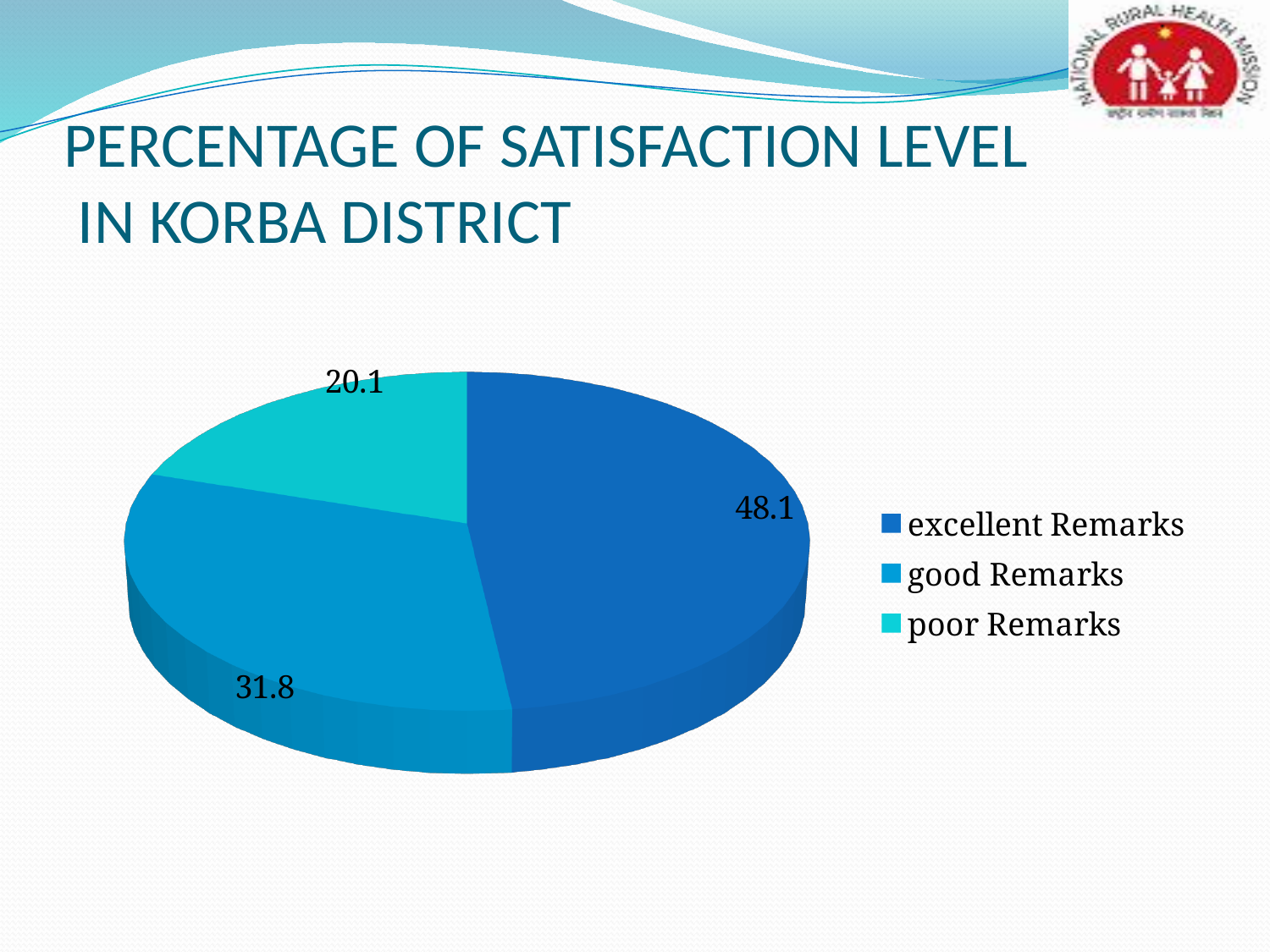
Which category has the smallest slice of the pie? poor Remarks What is the difference between the values for excellent Remarks and good Remarks? 16.3 What is the value for good Remarks? 31.8 Which legend entry is shown in the lightest (turquoise) colour? poor Remarks What is the difference between the values for good Remarks and poor Remarks? 11.7 What kind of chart is shown on the slide? pie chart Which is larger, the value for good Remarks or the value for poor Remarks? good Remarks How many categories does the pie chart show? 3 What is the title of the slide containing the chart? PERCENTAGE OF SATISFACTION LEVEL IN KORBA DISTRICT Which category has the largest slice of the pie? excellent Remarks What is the value for excellent Remarks? 48.1 What is the value for poor Remarks? 20.1